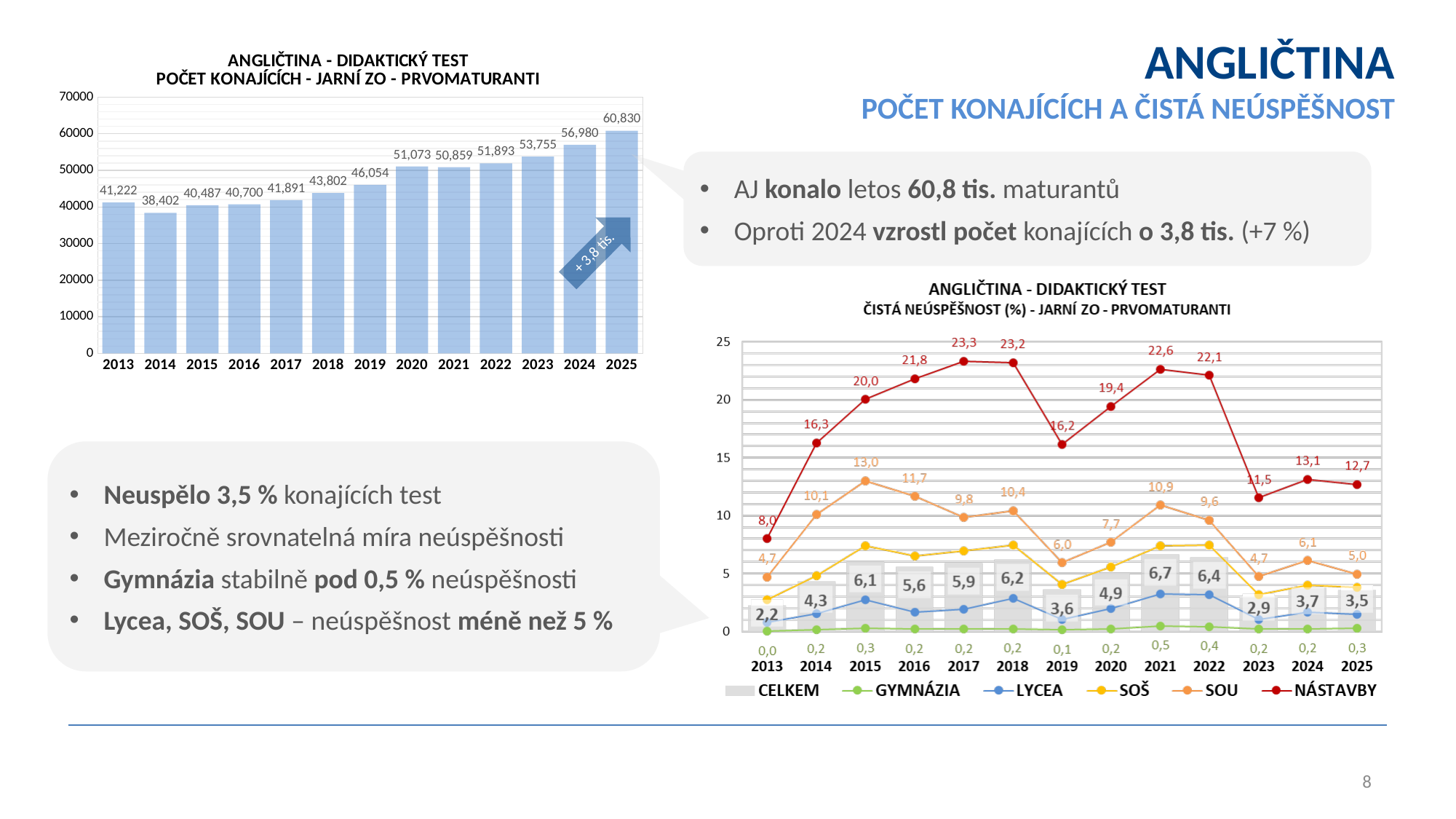
In the right chart (ČISTÁ NEÚSPĚŠNOST), what is the CELKEM value for 2021? 6,7 In the left chart (POČET KONAJÍCÍCH), which year has the lowest value? 2014 In the left chart (POČET KONAJÍCÍCH), is the value for 2020 greater or less than 50000? greater In the right chart (ČISTÁ NEÚSPĚŠNOST), what is the NÁSTAVBY value for 2017? 23,3 What kind of chart is the left chart (POČET KONAJÍCÍCH)? bar chart In the left chart (POČET KONAJÍCÍCH), how many years are shown on the x axis? 13 In the right chart (ČISTÁ NEÚSPĚŠNOST), what is the GYMNÁZIA value for 2021? 0,5 In the right chart (ČISTÁ NEÚSPĚŠNOST), how many series does the legend list? 6 In the left chart (POČET KONAJÍCÍCH), what is the difference between the 2025 and 2024 values? 3,850 In the right chart (ČISTÁ NEÚSPĚŠNOST), in which year is the SOU value highest? 2015 In the right chart (ČISTÁ NEÚSPĚŠNOST), which is larger in 2015: the SOU value or the CELKEM value? SOU In the left chart (POČET KONAJÍCÍCH), what is the value for 2025? 60,830